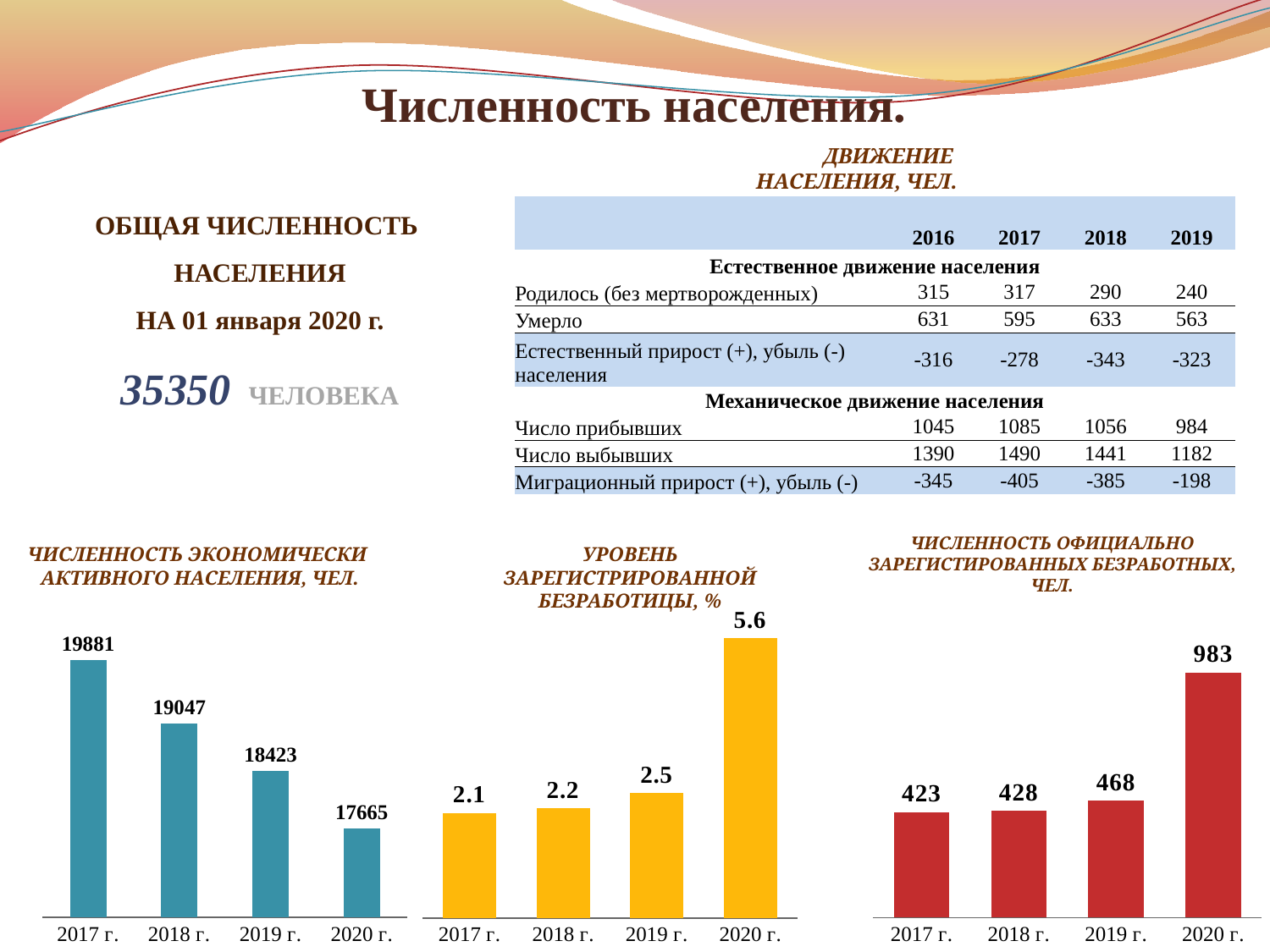
In the left chart (economically active population), what is the value for 2019 г.? 18423 In the left chart (economically active population), do the values rise or fall from 2017 г. to 2020 г.? fall In the middle chart (registered unemployment rate, %), what is the difference between the 2020 г. and 2019 г. values? 3.1 In the left chart (economically active population), which year has the highest value? 2017 г. In the middle chart (registered unemployment rate, %), what is the value for 2020 г.? 5.6 In the right chart (officially registered unemployed), which is larger, the value for 2019 г. or 2020 г.? 2020 г. In the right chart (officially registered unemployed), what is the difference between the 2020 г. and 2017 г. values? 560 In the right chart (officially registered unemployed), what is the value for 2018 г.? 428 In the left chart (economically active population), what is the difference between the 2017 г. and 2020 г. values? 2216 What type of chart is the middle chart (registered unemployment rate, %)? bar chart How many bars are in the right chart (officially registered unemployed)? 4 In the middle chart (registered unemployment rate, %), which year has the lowest value? 2017 г.